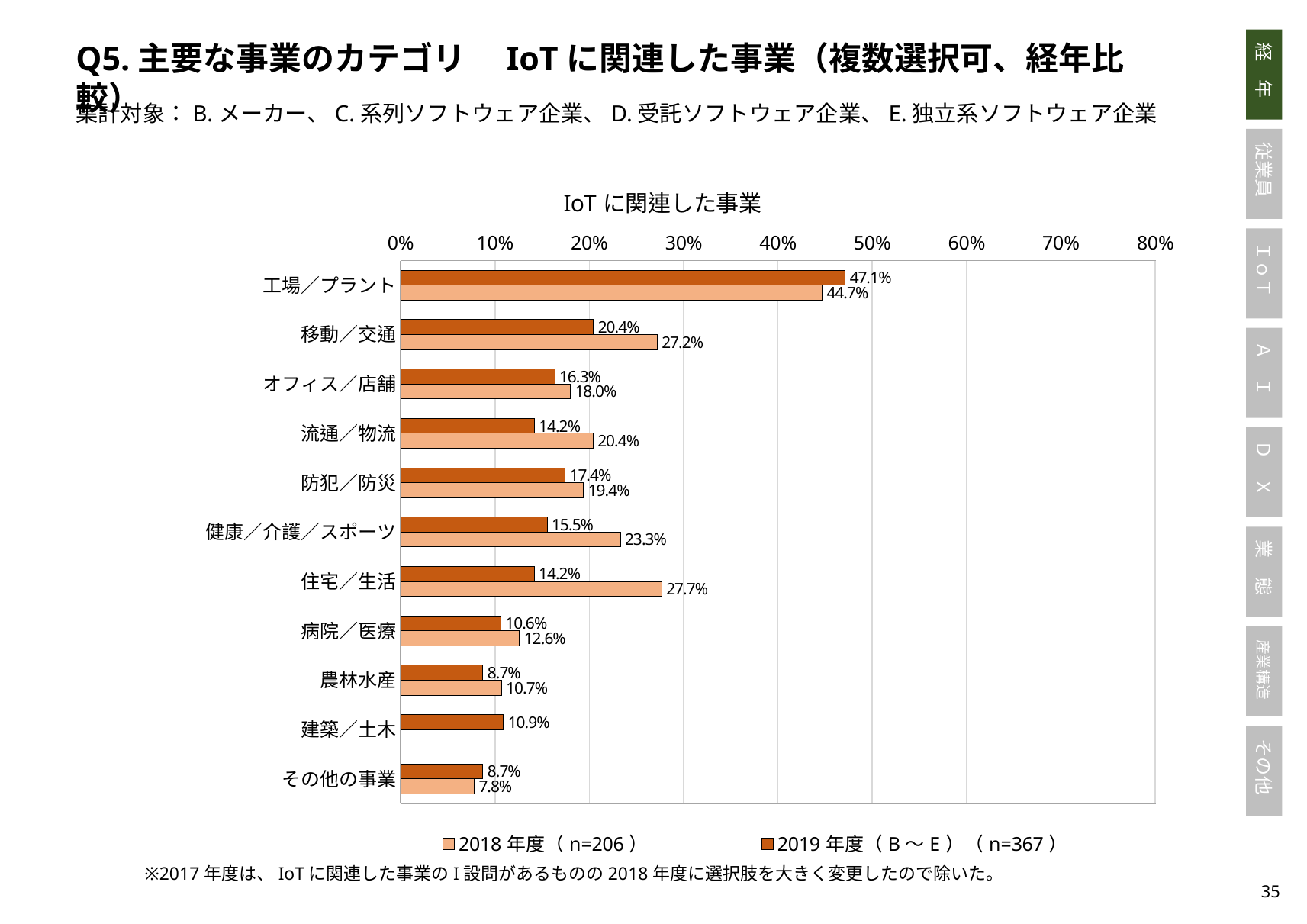
What kind of chart is shown on the slide? bar chart What is the difference between the 2018年度 and 2019年度 values for 健康／介護／スポーツ? 7.8% What is the 2018年度 value for 移動／交通? 27.2% Is the 2018年度 value for 工場／プラント greater or less than 40%? greater How many series does the legend list? 2 Which category has the highest 2019年度 value? 工場／プラント Which category has the lowest 2018年度 value? その他の事業 Which is larger for 病院／医療: the 2018年度 value or the 2019年度 value? 2018年度 What is the 2018年度 value for 住宅／生活? 27.7% What is the title of the chart? IoT に関連した事業 How many categories are shown on the chart? 11 What is the 2019年度 value for 工場／プラント? 47.1%